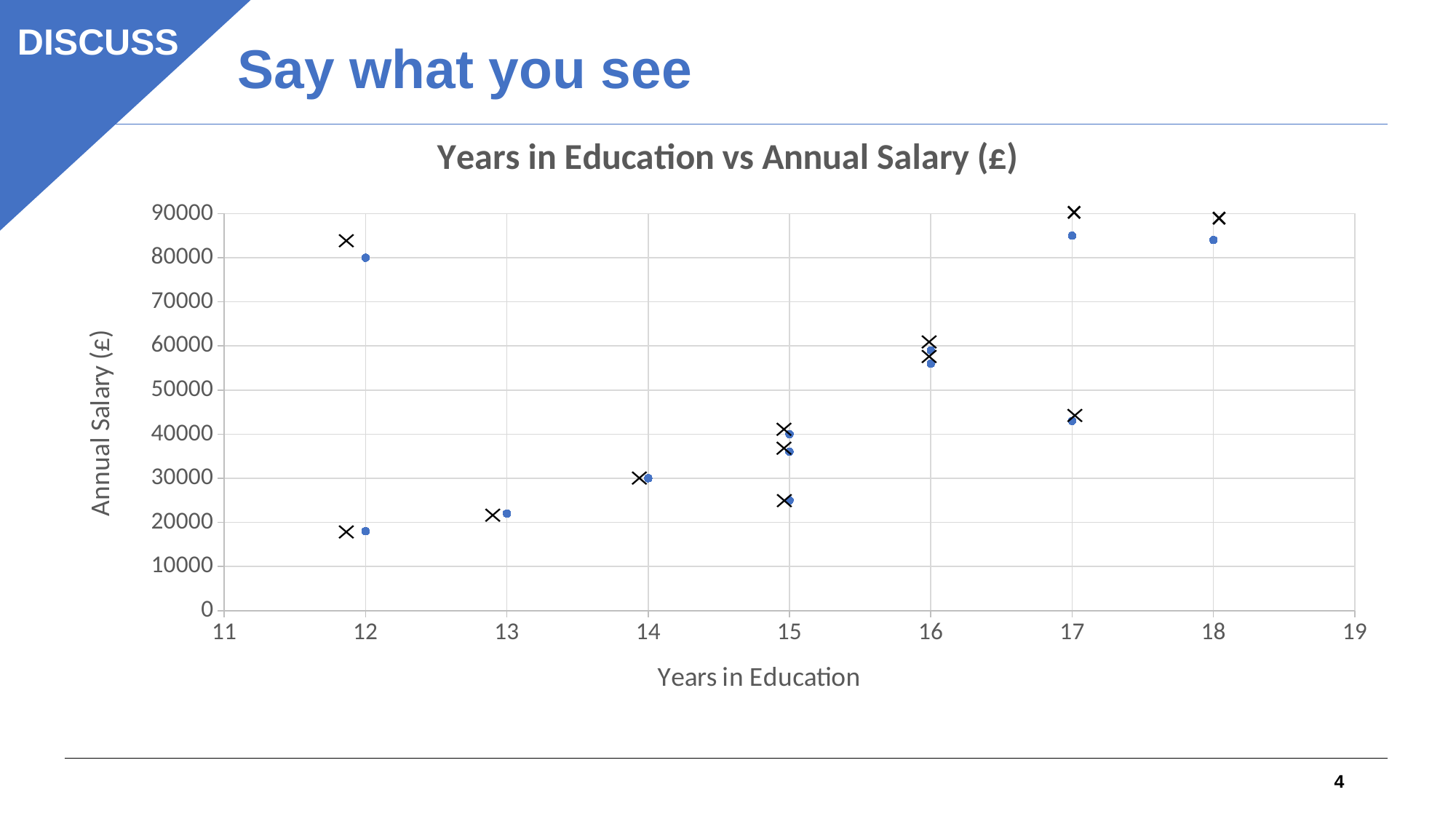
Is the annual salary for the lowest point at 15 years in education greater or less than 30000? less Which has the higher annual salary: the point at 14 years in education or the point at 16 years with the higher salary? 16 years Is the annual salary for the point at 14 years in education greater or less than 40000? less What is the title of the chart? Years in Education vs Annual Salary (£) What kind of chart is shown on the slide? Scatter chart What is the label of the vertical axis? Annual Salary (£) At how many years in education is the lowest annual salary point plotted? 12 Is the annual salary for the lower point at 17 years in education greater or less than 50000? less